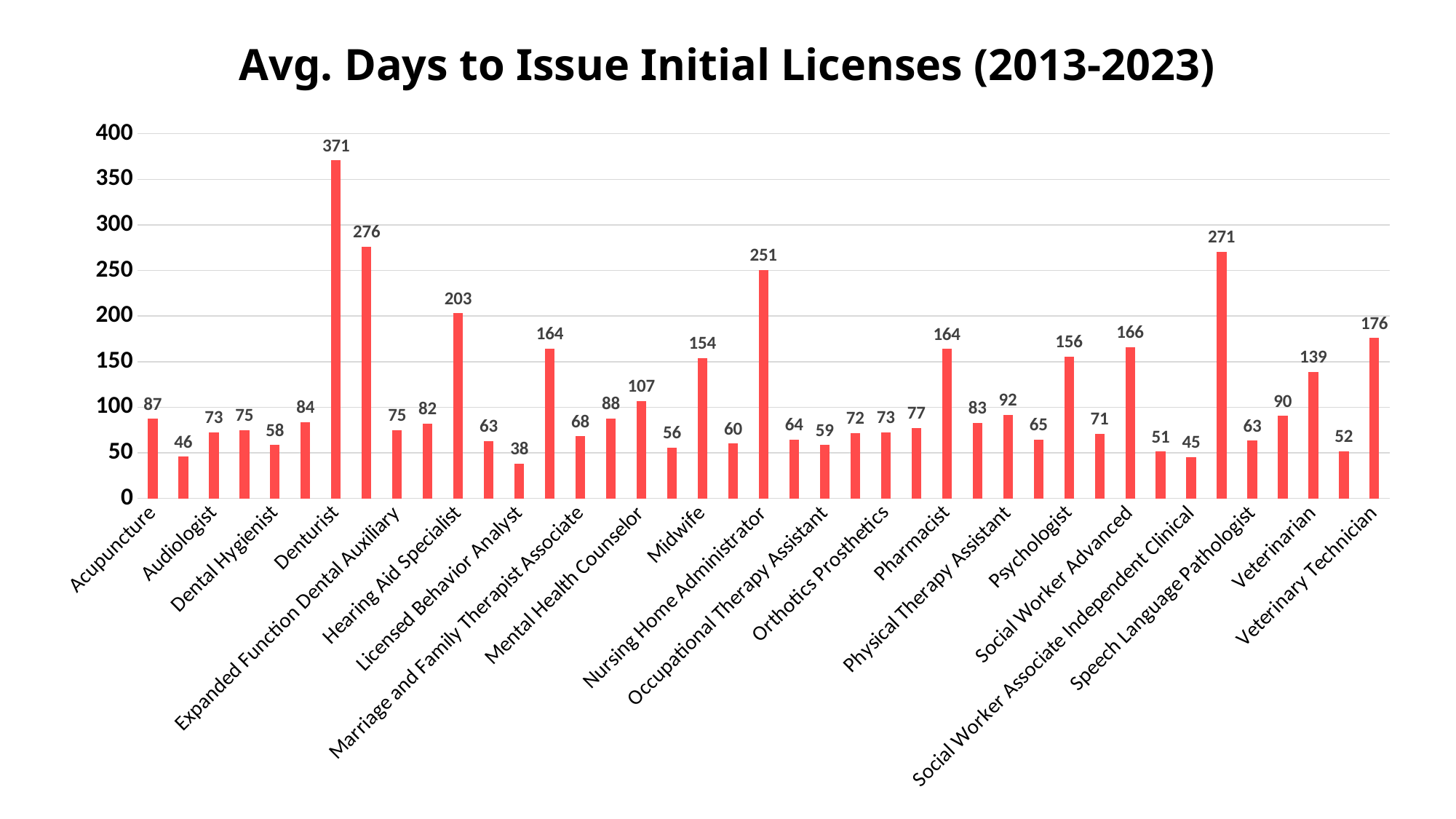
What is the average number of days to issue an initial license for Denturist? 371 What is the value shown for Licensed Behavior Analyst? 38 Is the value for Pharmacist greater or less than 150? greater What is the difference between the values for Denturist and Nursing Home Administrator? 120 Which labeled category has the highest average days to issue an initial license? Denturist What is the value shown for Hearing Aid Specialist? 203 Which labeled category has the lowest average days to issue an initial license? Licensed Behavior Analyst What is the value shown for Veterinary Technician? 176 What is the value shown for Nursing Home Administrator? 251 Which has a higher value, Midwife or Veterinarian? Midwife What is the title of the chart? Avg. Days to Issue Initial Licenses (2013-2023) What type of chart is shown on the slide? Bar chart